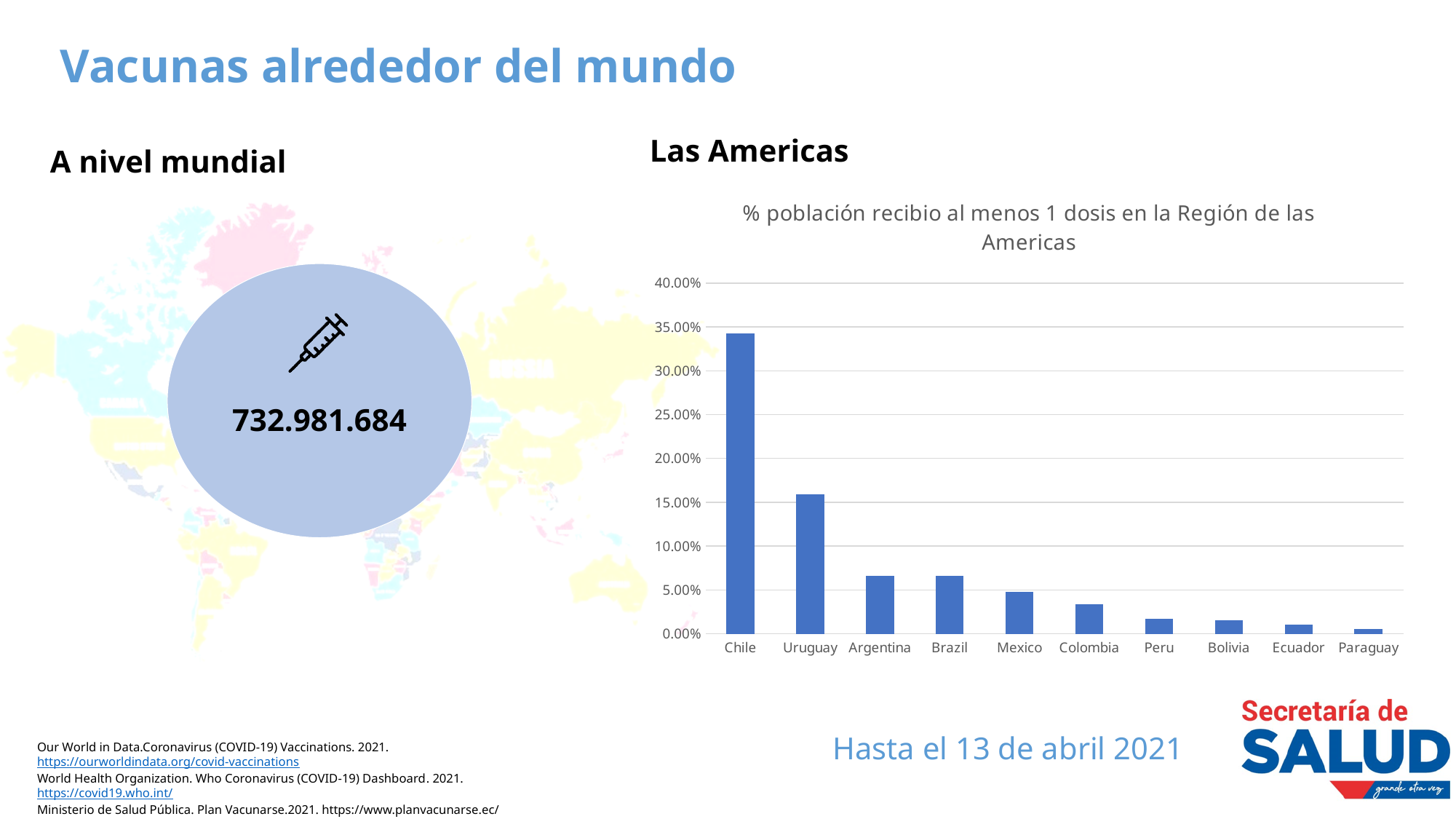
Which has a larger value, Chile or Uruguay? Chile Do the values rise or fall moving from left to right along the x axis? fall What is the title of the bar chart? % población recibio al menos 1 dosis en la Región de las Americas Is the value for Chile greater or less than 30.00%? greater Is the value for Uruguay greater or less than 10.00%? greater Is the value for Colombia greater or less than 5.00%? less Which country has the highest value in the bar chart? Chile Which country has the lowest value in the bar chart? Paraguay How many countries are shown on the x axis of the bar chart? 10 Which has a larger value, Mexico or Colombia? Mexico What kind of chart is shown under "Las Americas"? bar chart